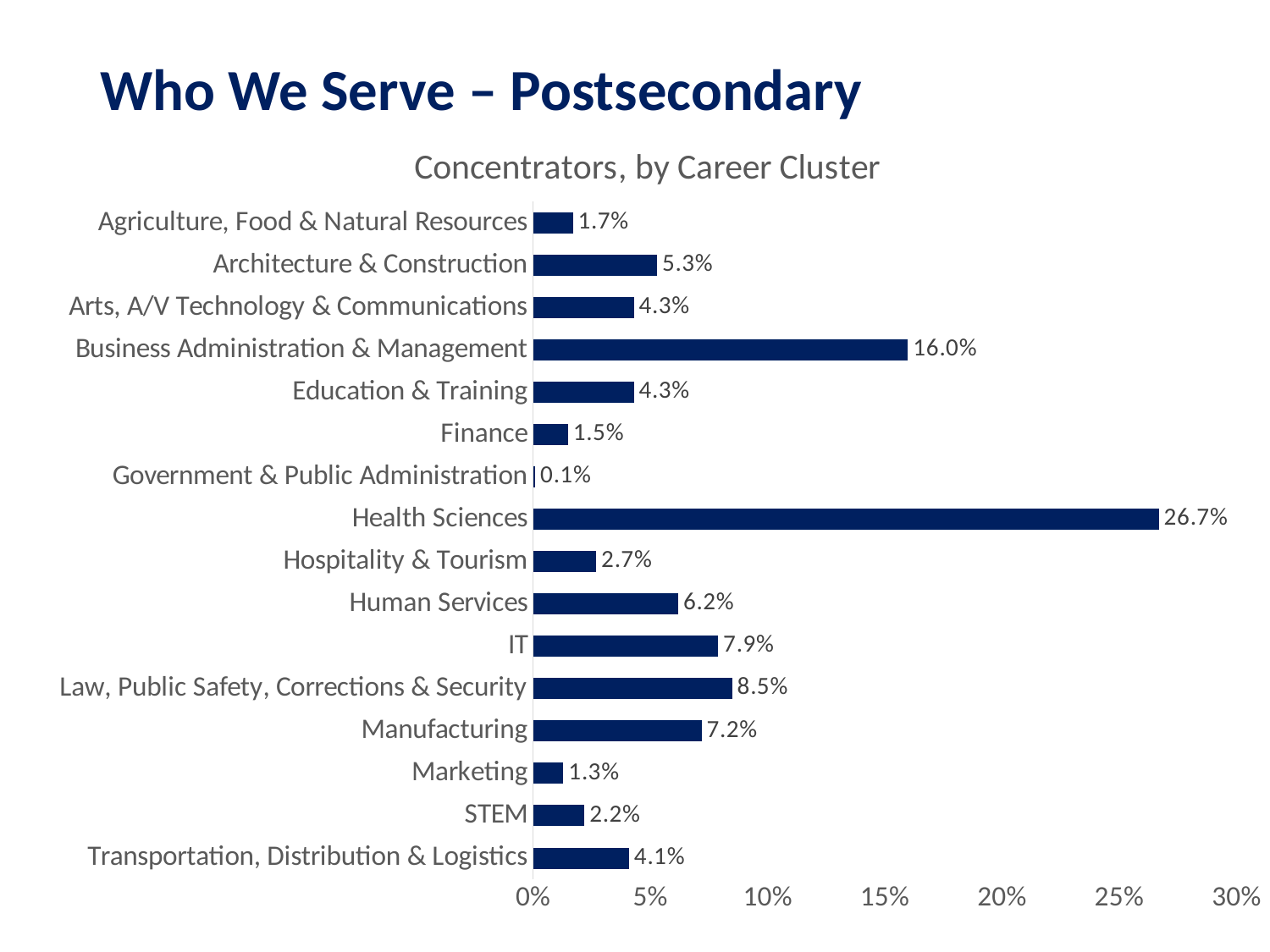
What is the difference between the values for Health Sciences and Business Administration & Management? 10.7% Which is larger, the value for IT or the value for Manufacturing? IT Is the value for Human Services greater or less than 5%? greater What is the title of the chart? Concentrators, by Career Cluster What is the value for Health Sciences? 26.7% What is the value for Marketing? 1.3% Which career cluster has the lowest share of concentrators? Government & Public Administration How many career clusters are shown in the chart? 16 What is the value for Business Administration & Management? 16.0% Which career cluster has the highest share of concentrators? Health Sciences What kind of chart is shown on the slide? Bar chart What is the value for Law, Public Safety, Corrections & Security? 8.5%